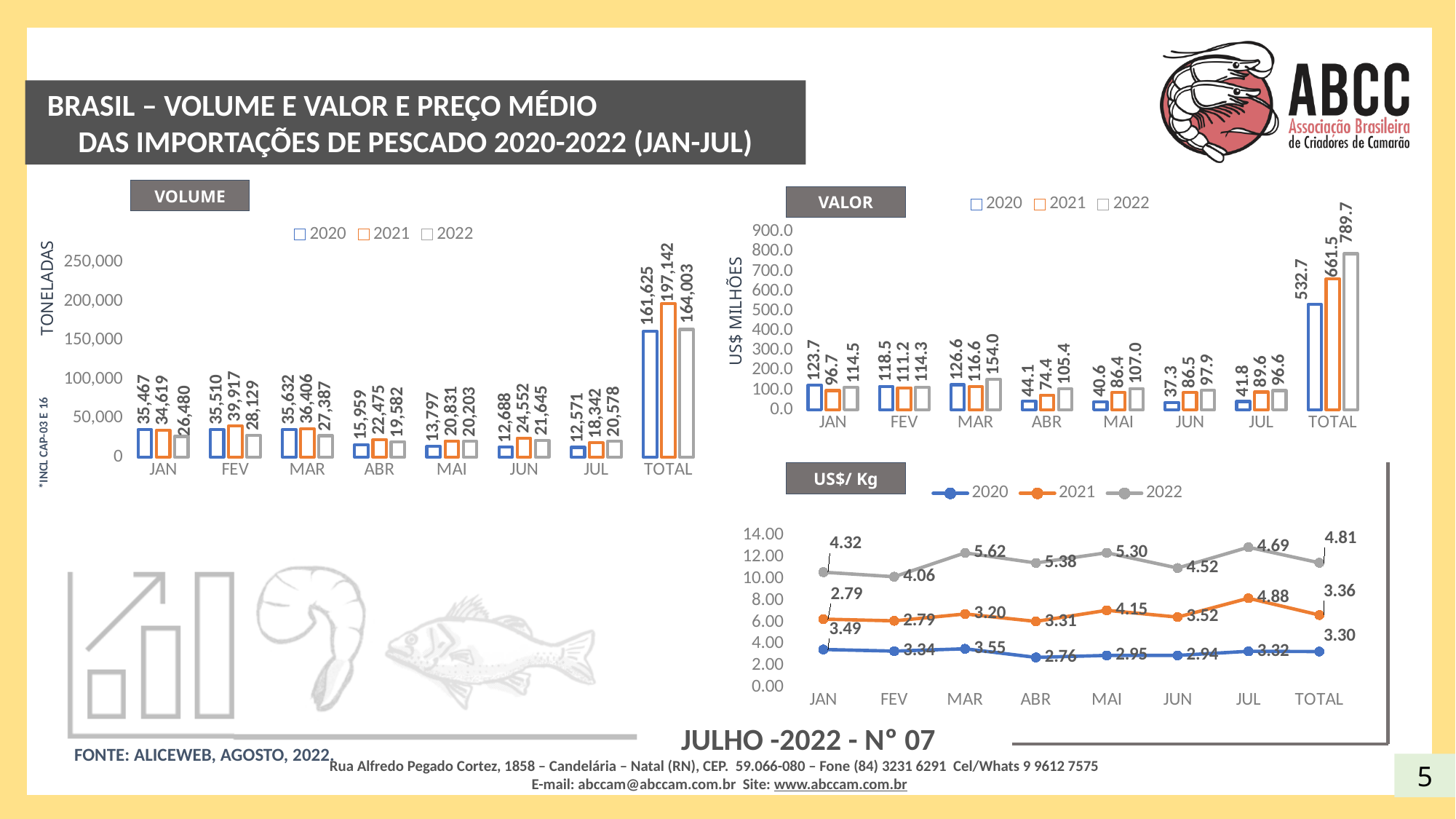
In the VOLUME chart, what is the difference between the 2021 and 2020 values in JUN? 11,864 In the VALOR chart, what is the value for 2022 in MAR? 154.0 In the VOLUME chart, which year has the highest TOTAL? 2021 How many series does the legend of the VOLUME chart list? 3 In the VALOR chart, what is the difference between the 2022 and 2020 TOTAL values? 257.0 In the VALOR chart, is the 2021 value in ABR larger or smaller than the 2022 value in ABR? smaller In the VALOR chart, which month has the lowest 2020 value? JUN In the VOLUME chart, what is the value for 2021 in FEV? 39,917 In the VOLUME chart, what is the TOTAL value for 2022? 164,003 In the US$/Kg chart, what is the 2022 value in MAR? 5.62 What type of chart is the US$/Kg chart? line chart In the US$/Kg chart, which month has the highest 2021 value? JUL